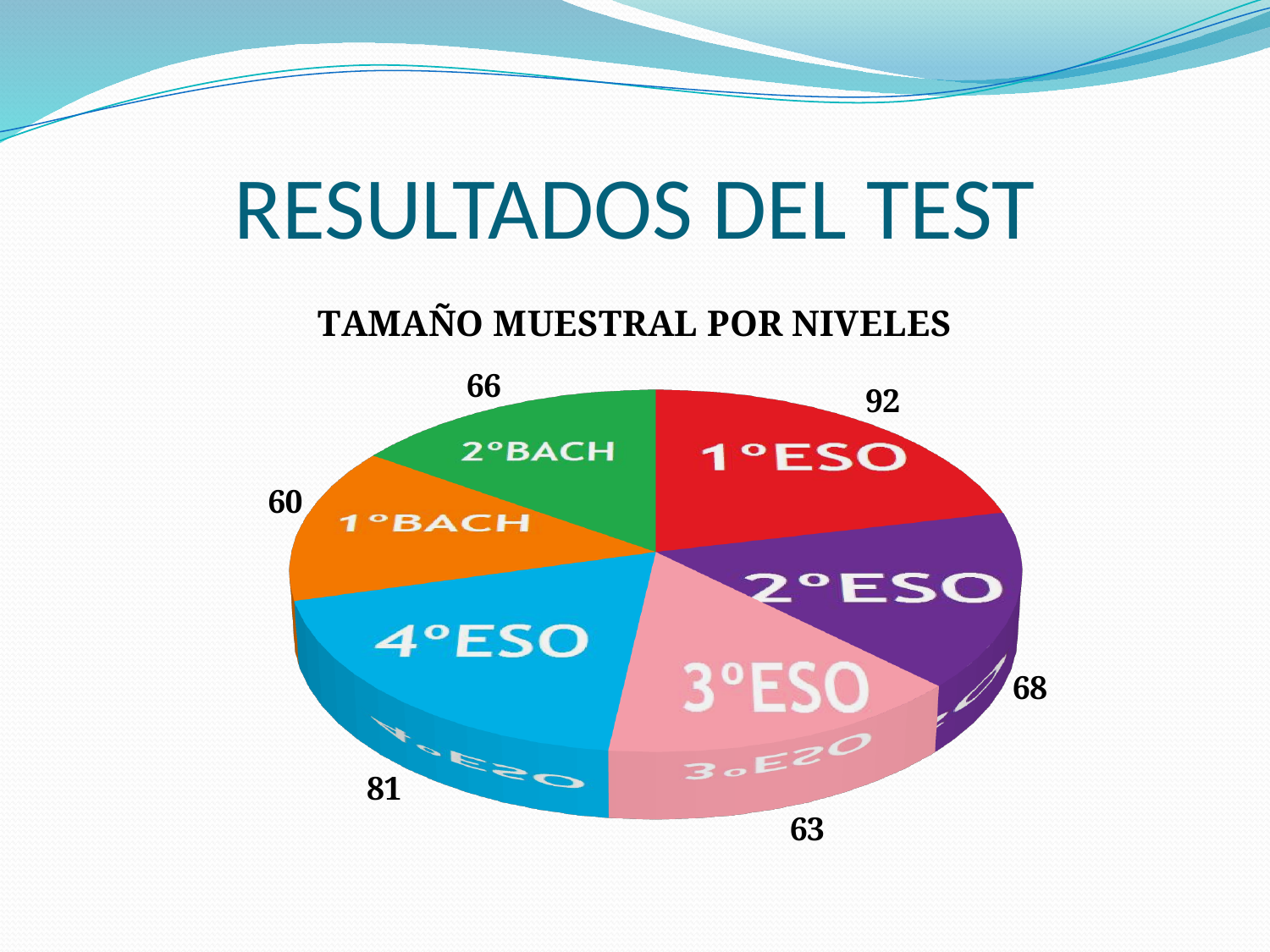
Which level has the smallest sample size? 1ºBACH What is the value for 4ºESO? 81 How many slices does the pie chart have? 6 Which level has the largest sample size? 1ºESO What is the difference between the values for 1ºESO and 3ºESO? 29 What type of chart is shown on the slide? pie chart What colour is the 3ºESO slice? pink Which is larger, the value for 2ºESO or the value for 2ºBACH? 2ºESO What is the title of the chart? TAMAÑO MUESTRAL POR NIVELES What is the total of all the slice values in the pie chart? 430 What is the value for 1ºBACH? 60 What is the value for 1ºESO? 92